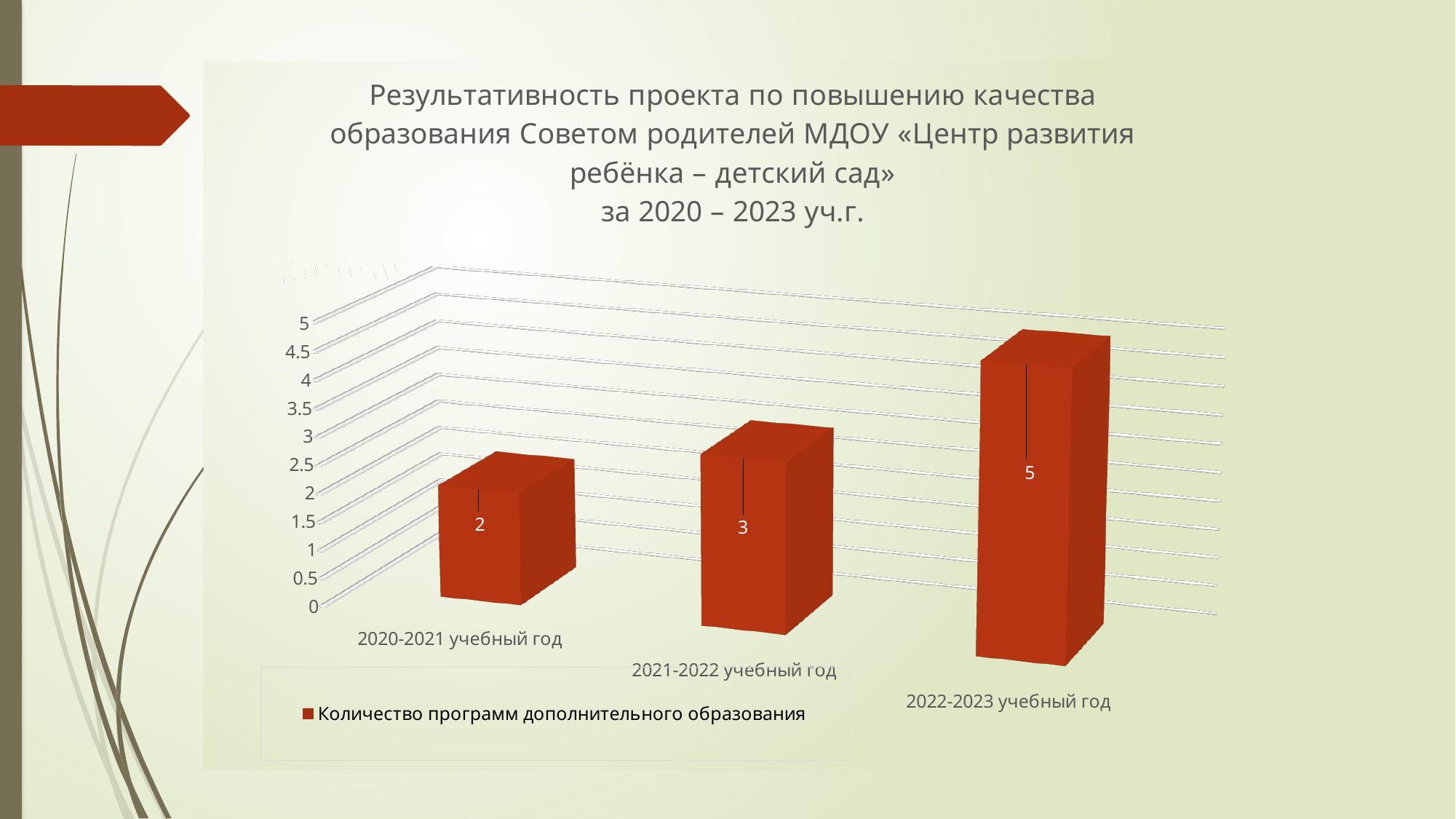
What kind of chart is shown on the slide? bar chart Which academic year has the highest value? 2022-2023 учебный год What is the value for 2020-2021 учебный год? 2 Is the value for 2022-2023 учебный год greater or less than 4? greater What is the difference between the values for 2022-2023 учебный год and 2020-2021 учебный год? 3 Which is larger, the value for 2021-2022 учебный год or 2020-2021 учебный год? 2021-2022 учебный год Which academic year has the lowest value? 2020-2021 учебный год How many series does the legend list? 1 How many academic years are shown on the chart? 3 What is the value for 2021-2022 учебный год? 3 What is the value for 2022-2023 учебный год? 5 Do the values rise or fall from 2020-2021 to 2022-2023? rise